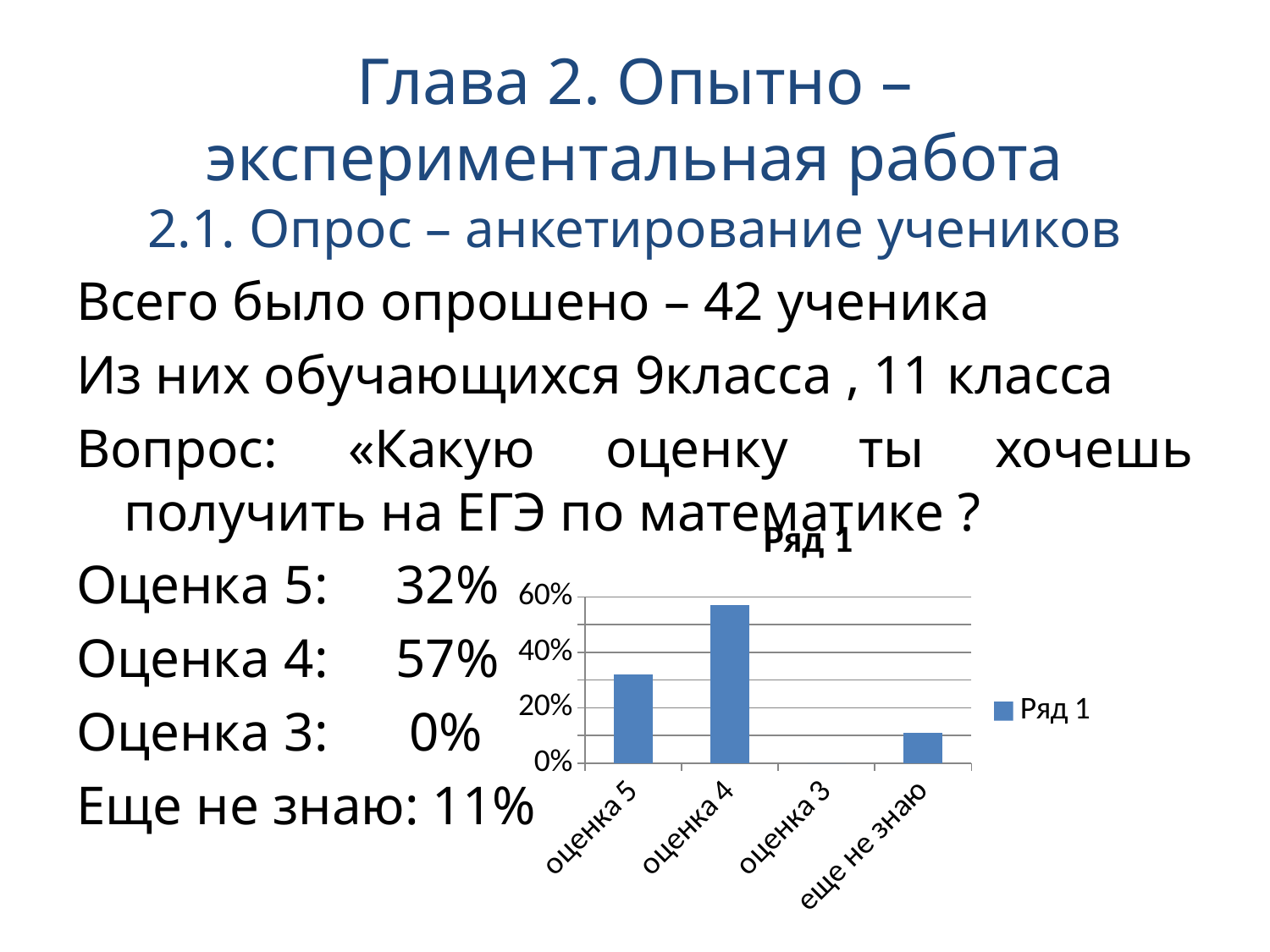
How many categories are shown on the x axis of the chart? 4 Which category has the highest bar in the chart? оценка 4 Which category has the lowest value in the chart? оценка 3 What kind of chart is shown on the slide? bar chart What is the value for еще не знаю in the chart? 11% What is the value for оценка 5 in the chart? 32% Is the value for оценка 4 greater or less than 40%? greater Is the value for еще не знаю greater or less than 20%? less What is the value for оценка 4 in the chart? 57% Which is larger, the value for оценка 5 or the value for еще не знаю? оценка 5 How many series does the chart legend list? 1 What is the title of the chart? Ряд 1